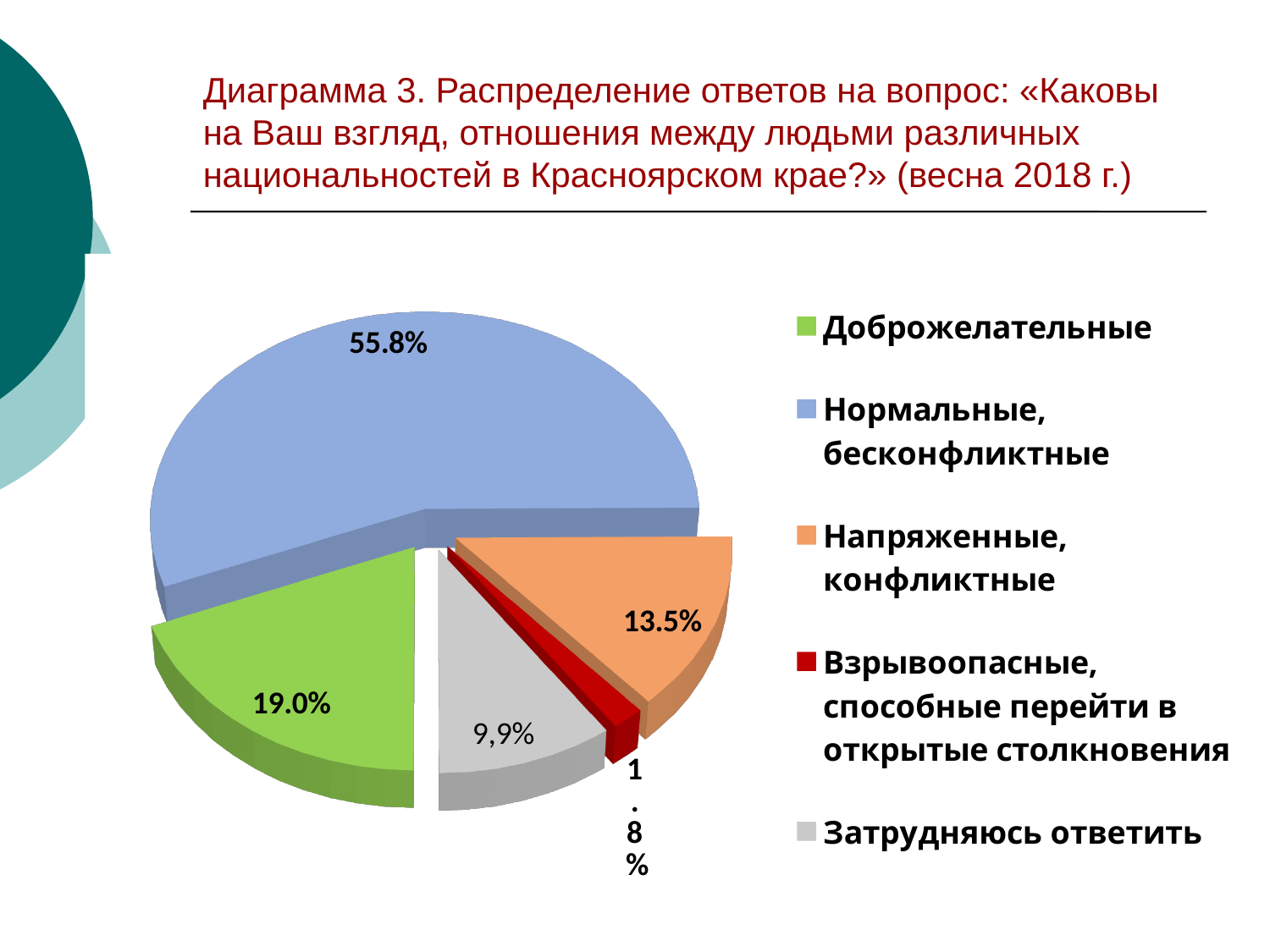
What is the difference in percentage points between «Нормальные, бесконфликтные» and «Доброжелательные»? 36.8 Which answer option has the largest share of the pie? Нормальные, бесконфликтные What share of respondents answered «Напряженные, конфликтные»? 13.5% How many slices does the pie chart have? 5 What share of respondents answered «Нормальные, бесконфликтные»? 55.8% What kind of chart is shown on the slide? pie chart What share of respondents answered «Затрудняюсь ответить»? 9,9% What share of respondents answered «Доброжелательные»? 19.0% Which is larger: the share for «Доброжелательные» or the share for «Напряженные, конфликтные»? Доброжелательные What share of respondents answered «Взрывоопасные, способные перейти в открытые столкновения»? 1.8% Which answer option has the smallest share of the pie? Взрывоопасные, способные перейти в открытые столкновения What colour is the slice for «Напряженные, конфликтные»? orange